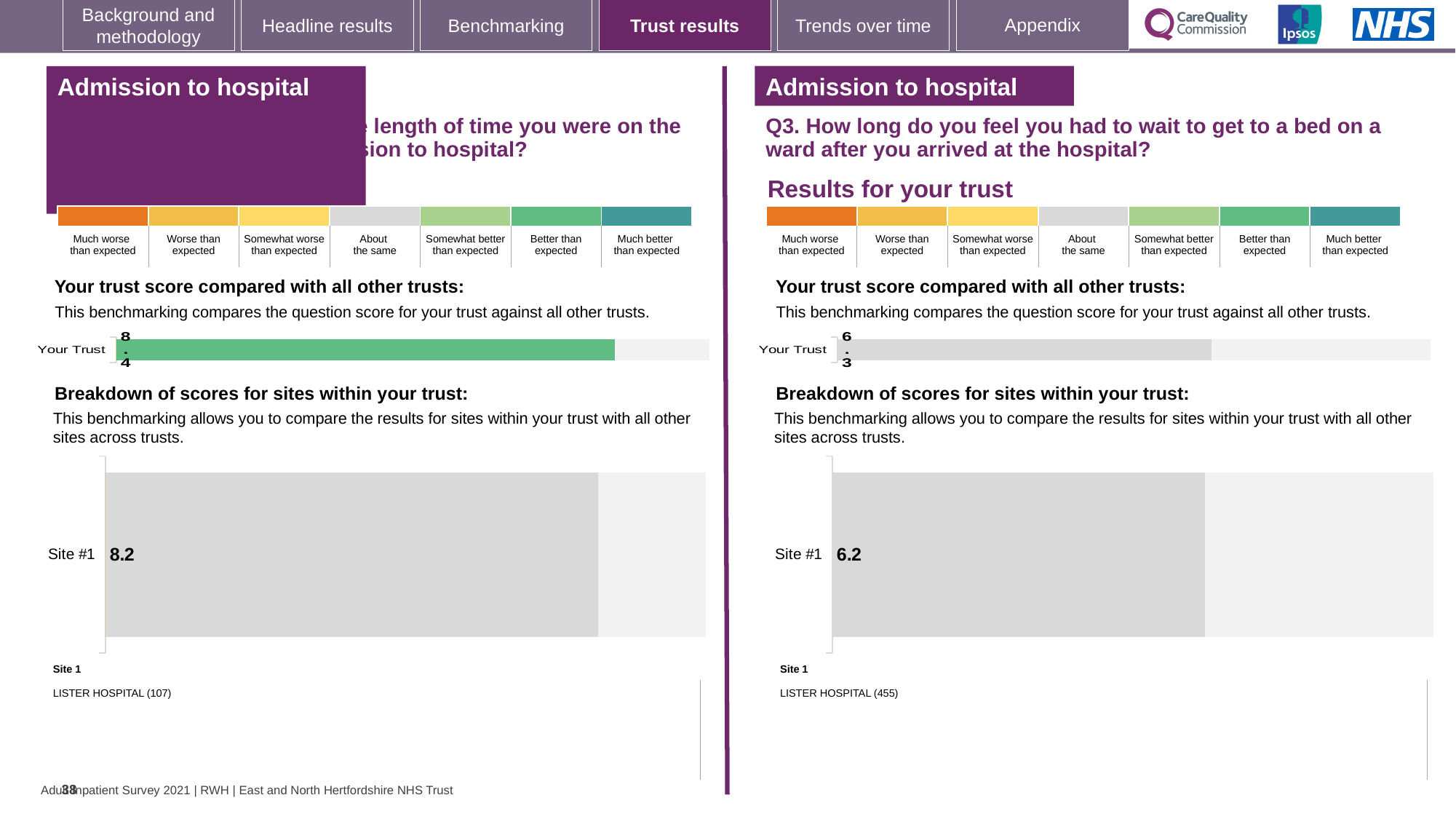
What colour is the Your Trust bar on the left 'Your trust score compared with all other trusts' chart? green What kind of chart is used to show the Your Trust score on the right Q3 side? bar chart Which is larger: the Site #1 score on the left chart or the Site #1 score on the right Q3 chart? the left chart (8.2) On the left 'Breakdown of scores for sites within your trust' chart, what is the score for Site #1? 8.2 Which is larger: the Your Trust score on the left chart or the Your Trust score on the right Q3 chart? the left chart (8.4) On the right Q3 'Breakdown of scores for sites within your trust' chart, what is the score for Site #1? 6.2 On the right Q3 side, which hospital is listed as Site 1? LISTER HOSPITAL (455) On the right Q3 side of the slide, what is the difference between the Your Trust score and the Site #1 score? 0.1 On the left 'Your trust score compared with all other trusts' chart, what is the score for Your Trust? 8.4 On the left side of the slide, what is the difference between the Your Trust score and the Site #1 score? 0.2 On the right Q3 'Your trust score compared with all other trusts' chart, what is the score for Your Trust? 6.3 How many sites are shown in the left 'Breakdown of scores for sites within your trust' chart? 1